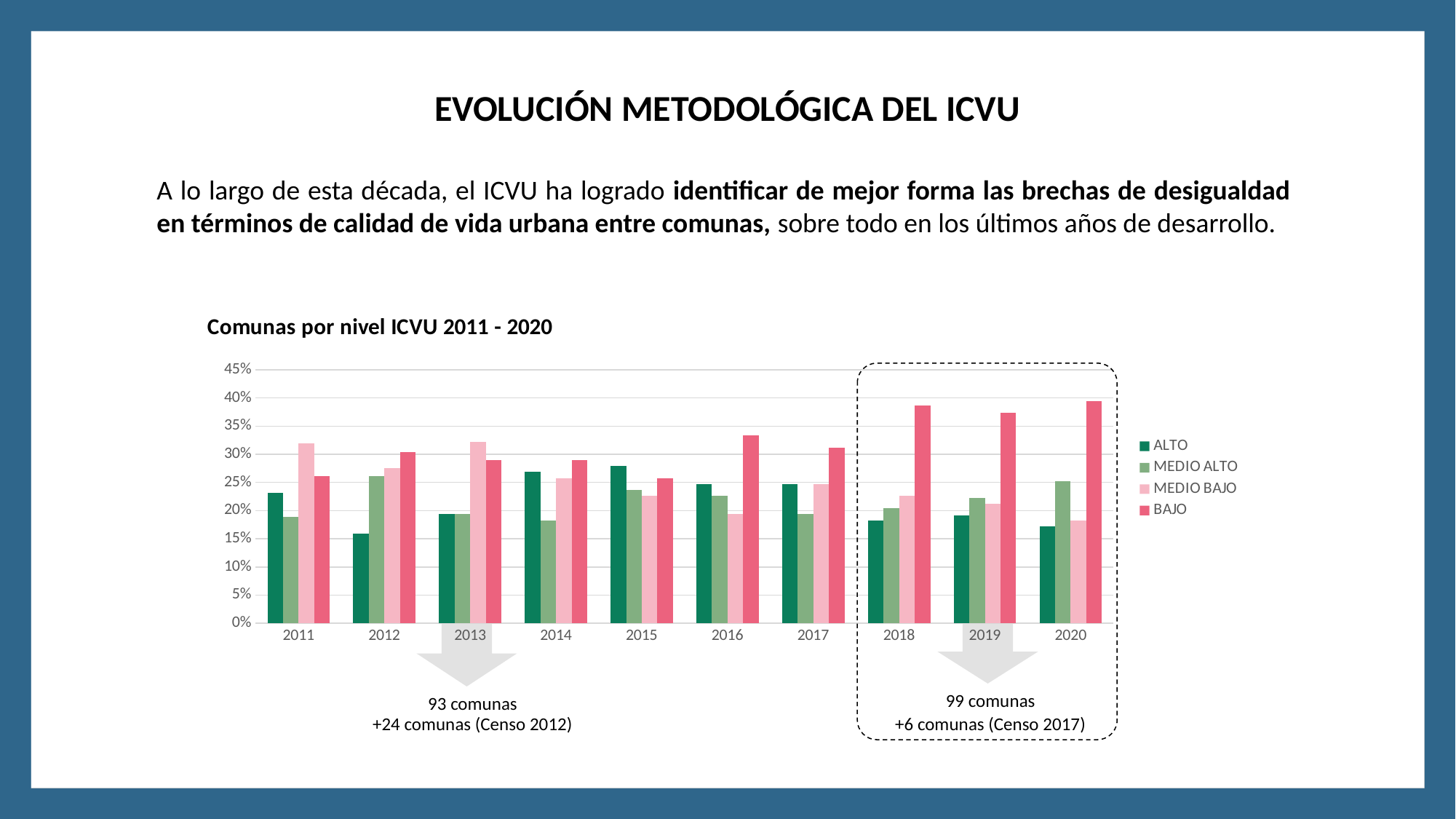
Is the value for MEDIO BAJO in 2011 greater or less than 30%? greater Is the value for BAJO in 2020 higher or lower than in 2011? higher What is the title of the chart? Comunas por nivel ICVU 2011 - 2020 How many years are shown on the x axis of the chart? 10 Is the value for ALTO in 2012 greater or less than 20%? less Which series has the lowest value in 2012? ALTO Is the value for BAJO in 2018 greater or less than 35%? greater What kind of chart is shown on the slide? Bar chart Which series has the highest value in 2011? MEDIO BAJO How many series does the legend of the chart list? 4 In 2016, which is larger: BAJO or ALTO? BAJO Which series has the highest value in 2018? BAJO